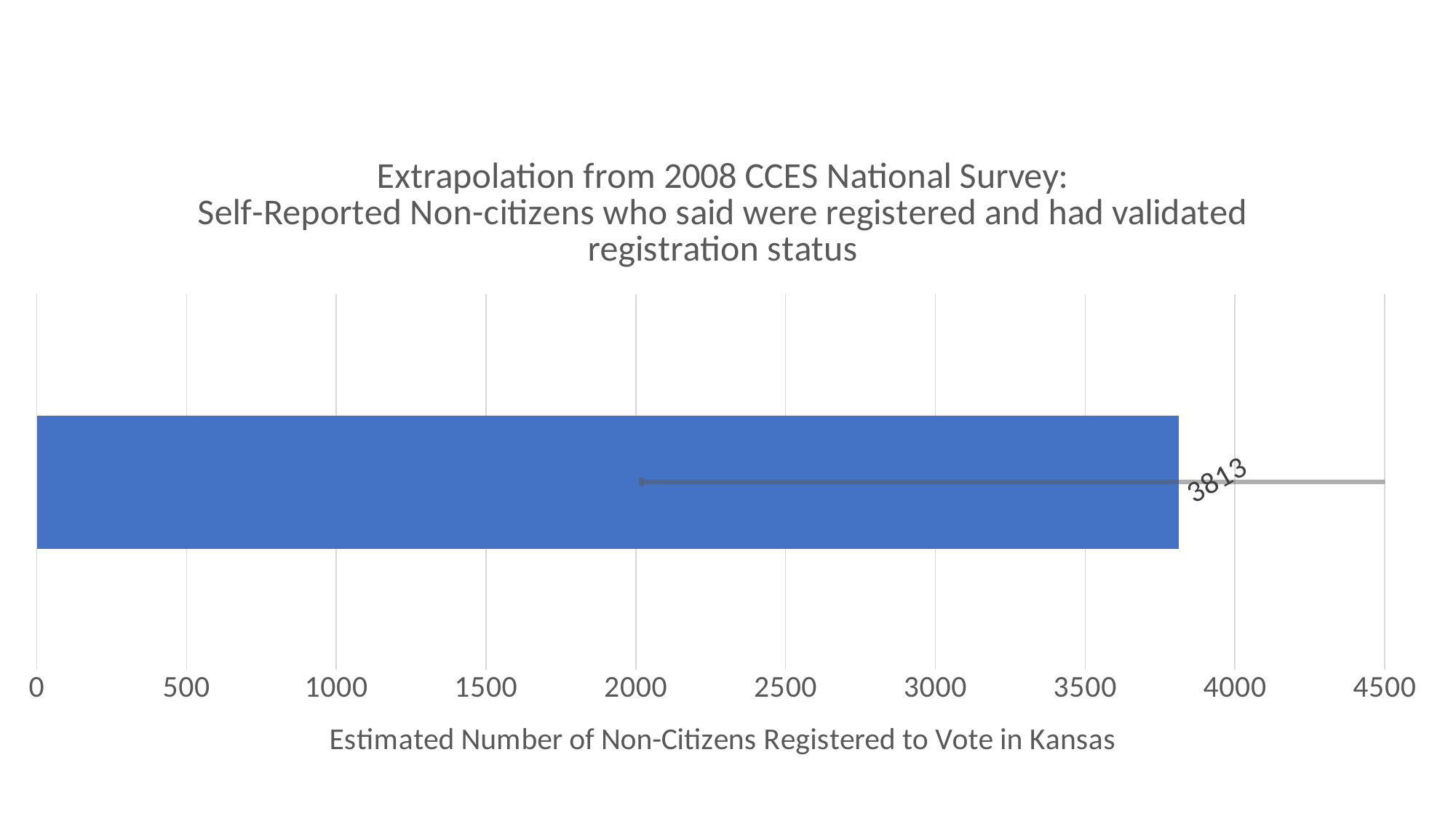
Is the value of the bar greater or less than 4000? less What value is printed on the bar in the chart? 3813 How many bars are plotted in the chart? 1 What kind of chart is shown on the slide? bar chart What is the highest tick value shown on the x axis? 4500 Is the value of the bar greater or less than 3500? greater What is the title of the x axis? Estimated Number of Non-Citizens Registered to Vote in Kansas